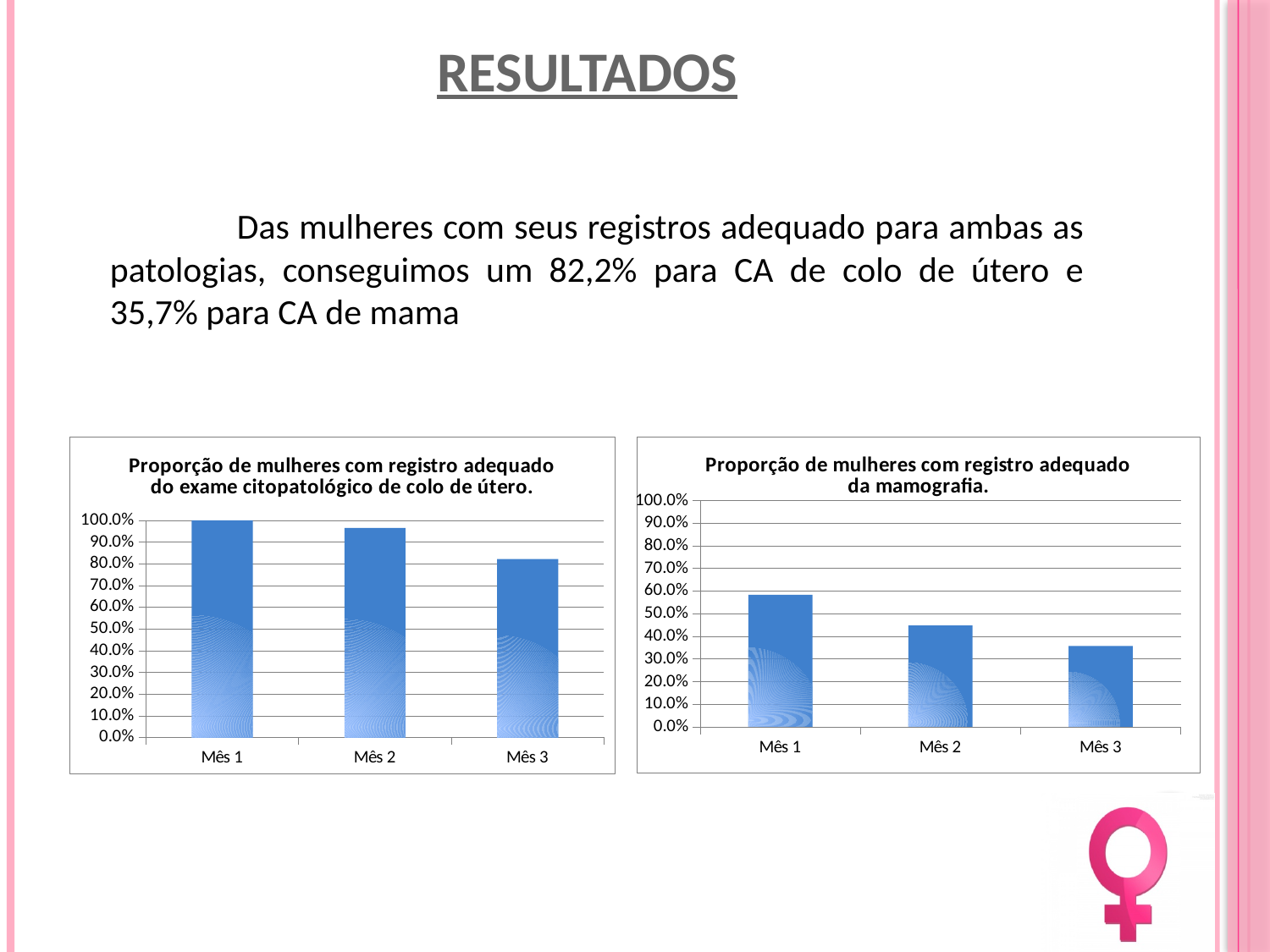
In the right chart (mamografia), is the value for Mês 3 greater or less than 40.0%? less In the left chart (exame citopatológico de colo de útero), is the value for Mês 2 greater or less than 90.0%? greater In the right chart (mamografia), which month has the highest value? Mês 1 In the left chart (exame citopatológico de colo de útero), which month has the highest value? Mês 1 In the left chart (exame citopatológico de colo de útero), which month has the lowest value? Mês 3 In the left chart (exame citopatológico de colo de útero), what is the value for Mês 1? 100.0% How many categories are shown on the x axis of the right chart, 'Proporção de mulheres com registro adequado da mamografia.'? 3 Which is larger: the value for Mês 2 in the left chart (exame citopatológico) or the value for Mês 2 in the right chart (mamografia)? Mês 2 in the left chart (exame citopatológico) In the right chart (mamografia), do the values rise or fall from Mês 1 to Mês 3? fall In the right chart (mamografia), is the value for Mês 1 greater or less than 50.0%? greater What kind of chart is the left chart, 'Proporção de mulheres com registro adequado do exame citopatológico de colo de útero.'? bar chart